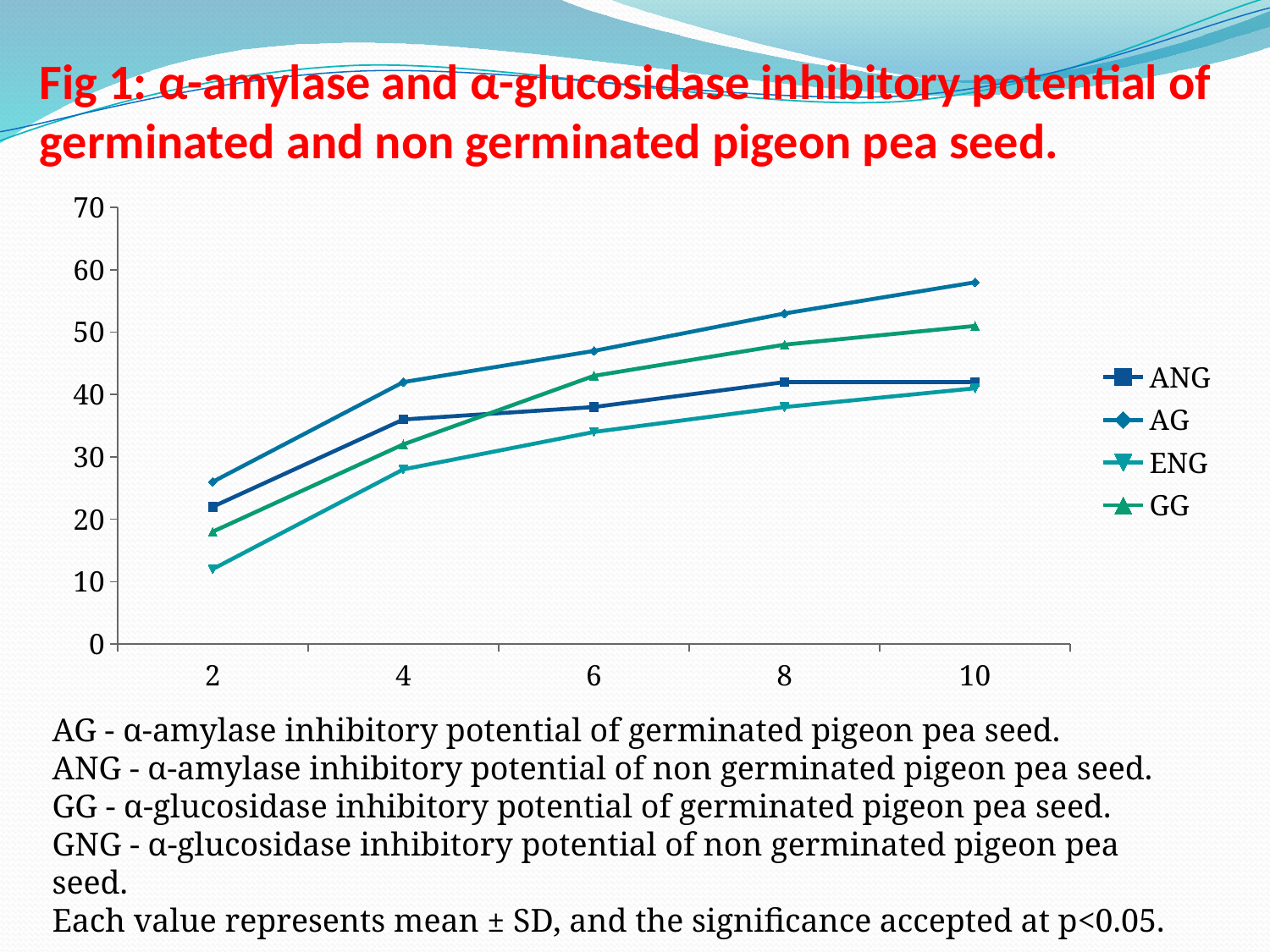
Which series has the highest value at x = 10? AG Is the value for ENG at x = 2 greater or less than 20? less How many series does the legend list? 4 What kind of chart is shown on the slide? line chart Do the values for AG rise or fall as x increases from 2 to 10? rise Is the value for ANG at x = 4 greater or less than 30? greater At x = 6, which series has the larger value, GG or ANG? GG Is the value for GG at x = 8 greater or less than 40? greater Which series has the lowest value at x = 2? ENG How many x-axis points are plotted for each series? 5 What are the four entries listed in the chart legend? ANG, AG, ENG, GG